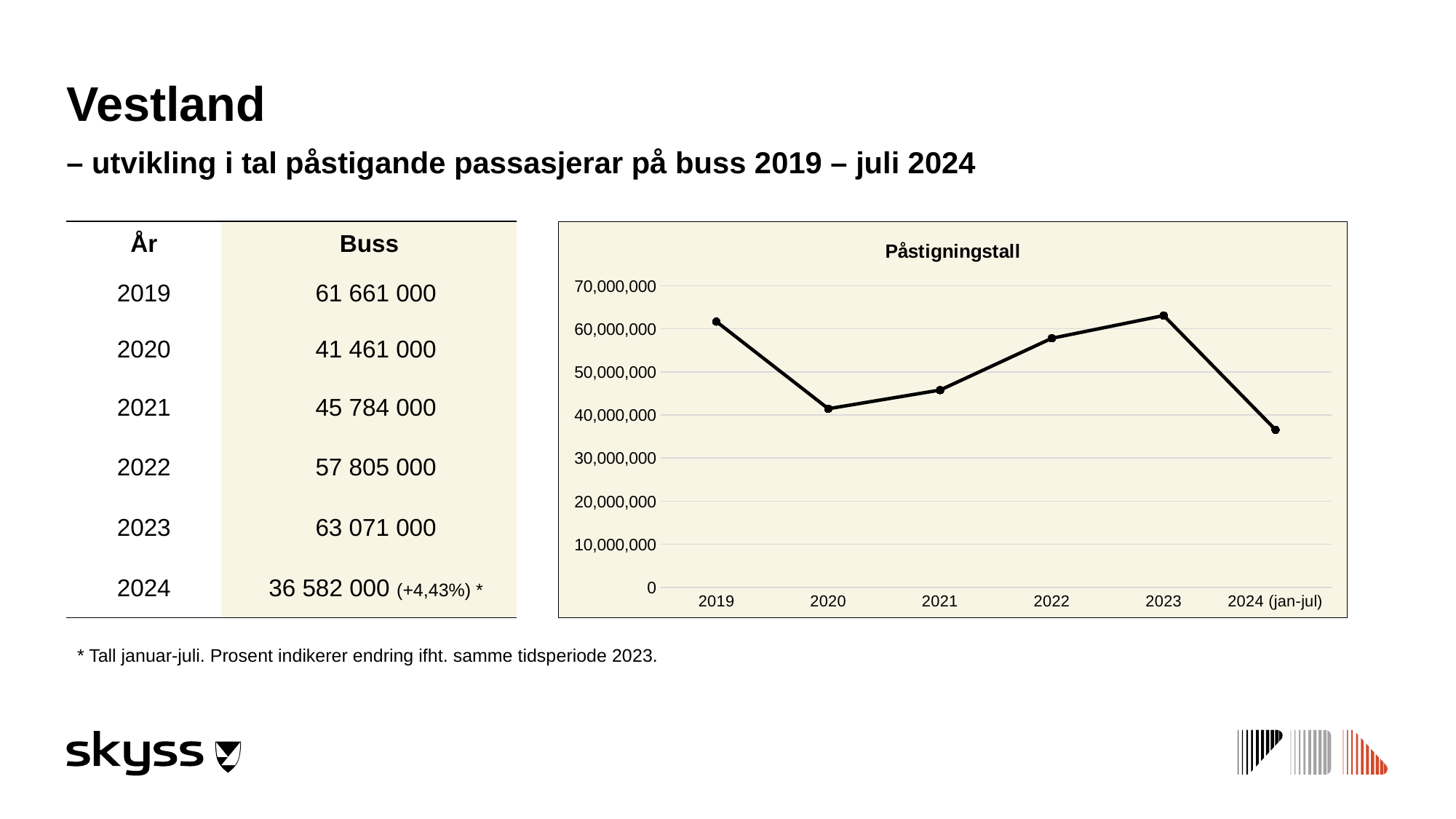
According to the slide, what is the bus passenger count (Buss) for 2020? 41 461 000 What is the title of the chart? Påstigningstall What is the difference between the 2023 and 2022 bus passenger counts shown on the slide? 5 266 000 Which is larger, the value for 2021 or the value for 2022? 2022 What kind of chart is shown on the slide? Line chart How many data points are plotted on the line chart? 6 Which full year (2019–2023) has the highest number of boardings? 2023 According to the slide, what is the bus passenger count (Buss) for 2023? 63 071 000 Which point on the chart is the lowest? 2024 (jan-jul) Is the value for 2022 on the chart greater or less than 50,000,000? greater Is the value for 2020 on the chart greater or less than 50,000,000? less According to the slide, what is the bus passenger count (Buss) for 2019? 61 661 000